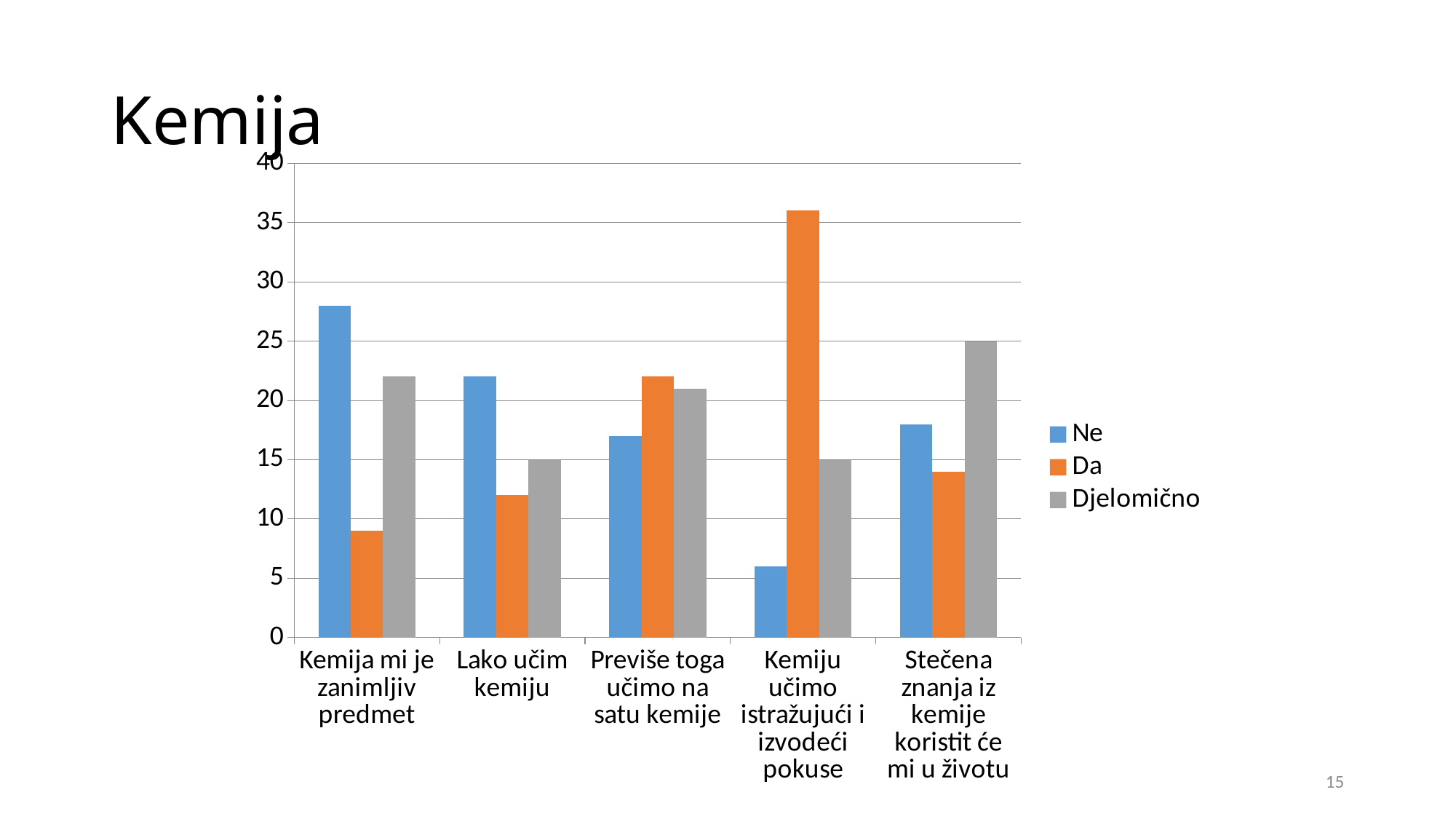
What is the value of the Djelomično bar for "Stečena znanja iz kemije koristit će mi u životu"? 25 Is the Da value for "Kemiju učimo istražujući i izvodeći pokuse" greater or less than 35? greater What kind of chart is shown on the slide? bar chart Which category has the highest Da value? Kemiju učimo istražujući i izvodeći pokuse How many categories are shown on the x axis of the chart? 5 What is the value of the Djelomično bar for "Lako učim kemiju"? 15 Which colour represents the Da series in the legend? orange Is the Da value for "Kemija mi je zanimljiv predmet" greater or less than 10? less Which category has the lowest Ne value? Kemiju učimo istražujući i izvodeći pokuse For "Lako učim kemiju", which is larger: the Ne value or the Da value? Ne How many series does the legend list? 3 Which category has the highest Ne value? Kemija mi je zanimljiv predmet